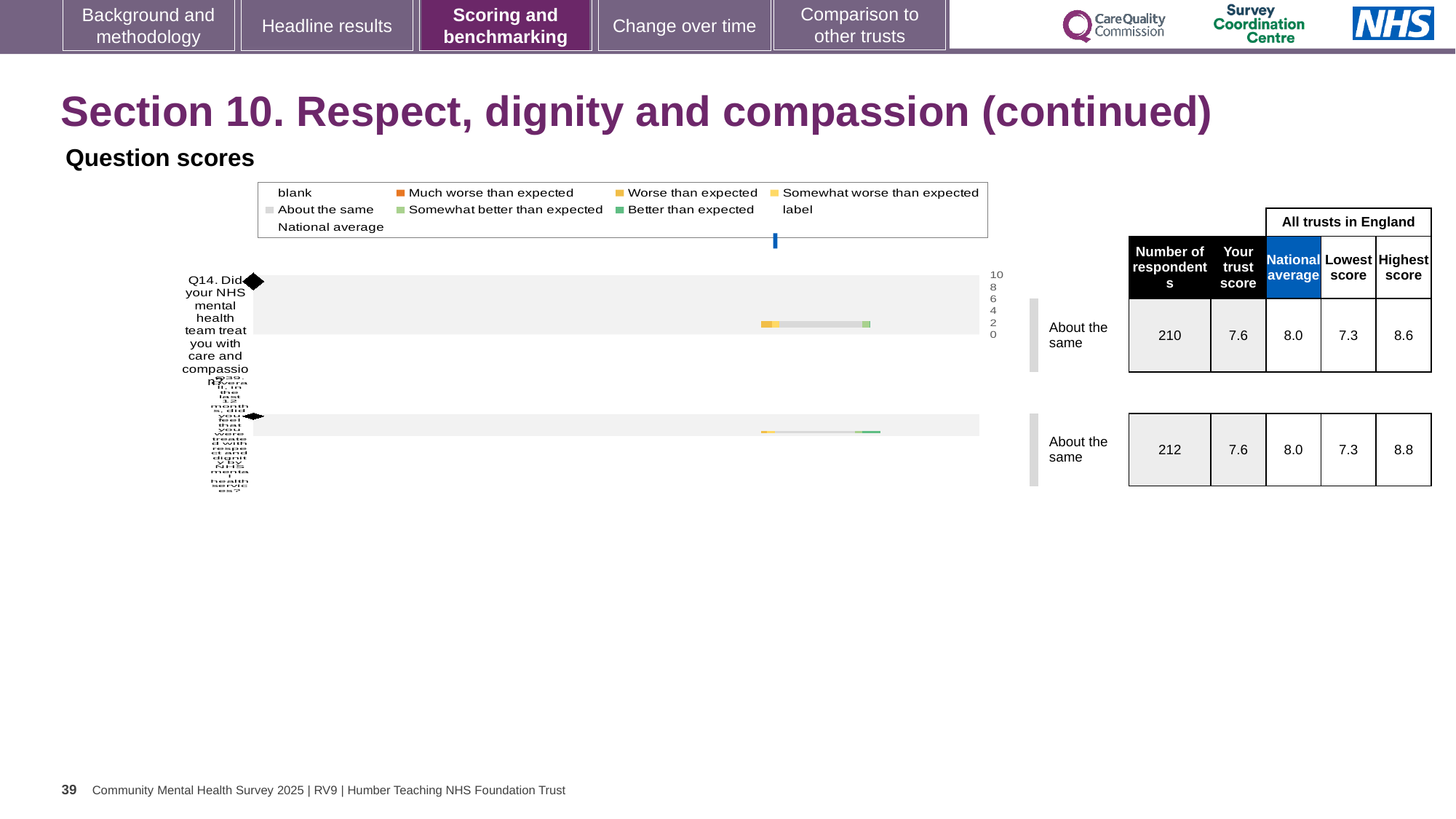
In the table next to the chart, what is the trust's score for Q14? 7.6 In the table next to the chart, what is the lowest score among all trusts in England for Q39? 7.3 In the table next to the chart, how many respondents are listed for Q14? 210 In the table next to the chart, what is the national average for Q14? 8.0 How many questions (categories) are plotted in the question scores chart? 2 What is the difference between the highest score and the lowest score for Q14 in the table? 1.3 Which question has the larger highest score in the table, Q14 or Q39? Q39 In the table next to the chart, what is the highest score among all trusts in England for Q39? 8.8 What colour does the legend use for 'Better than expected'? green Is the trust's score for Q39 greater or less than 6 on the chart's 0–10 scale? greater What kind of chart is used to show the question scores on this slide? bar chart What benchmark category is shown for Q14 next to the chart? About the same